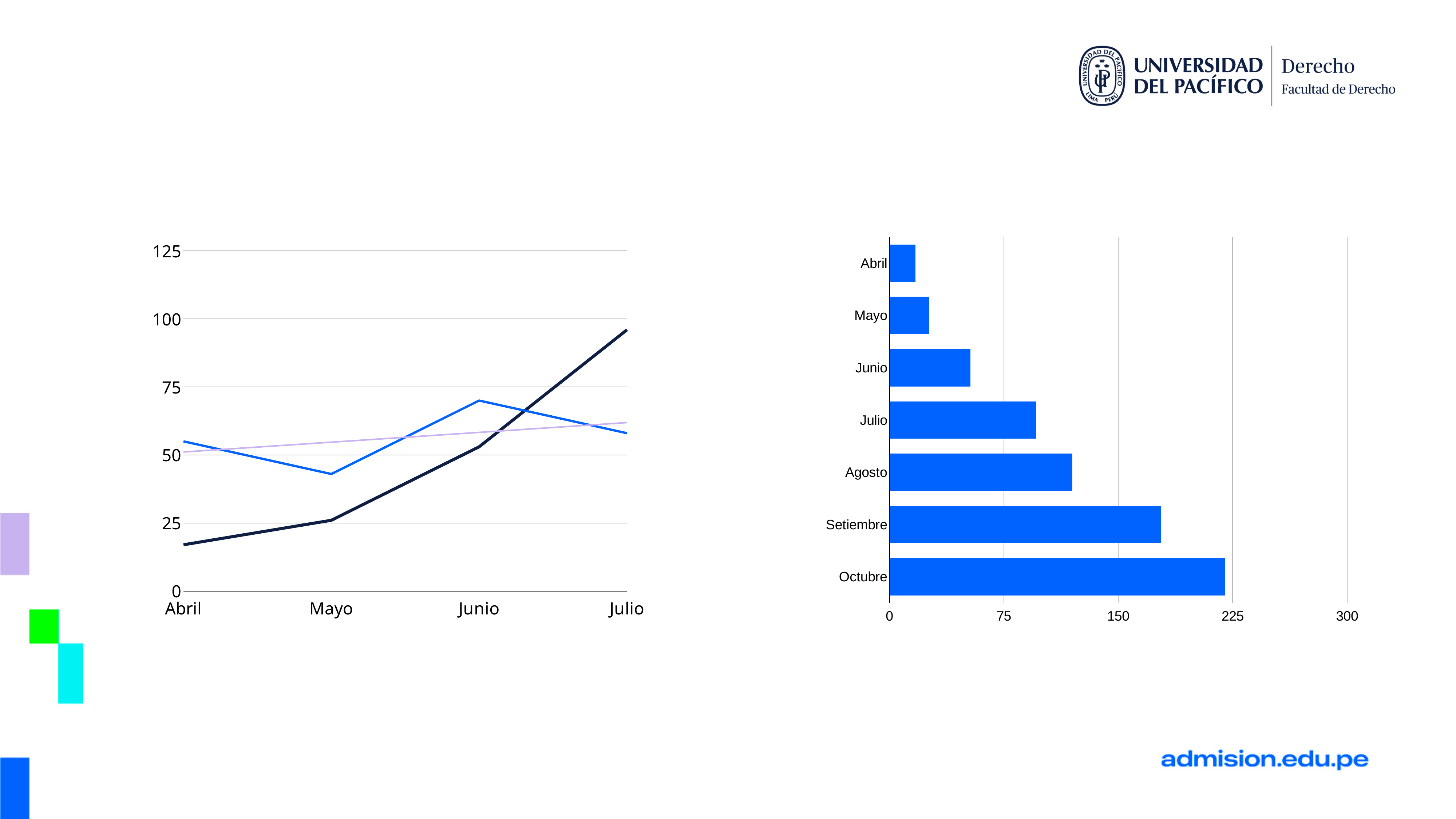
How many months are shown on the x axis of the line chart on the left? 4 In the bar chart on the right, is the value for Setiembre greater or less than 150? greater In the line chart on the left, is the value of the dark navy line at Abril greater or less than 25? less In the bar chart on the right, which month has the highest value? Octubre What kind of chart is the chart on the right side of the slide? bar chart In the bar chart on the right, which month has the lowest value? Abril In the line chart on the left, does the dark navy line rise or fall from Abril to Julio? rise In the bar chart on the right, is the value for Agosto greater or less than 150? less How many months are shown in the bar chart on the right? 7 What kind of chart is the chart on the left side of the slide? line chart In the bar chart on the right, which is larger, the value for Julio or the value for Mayo? Julio